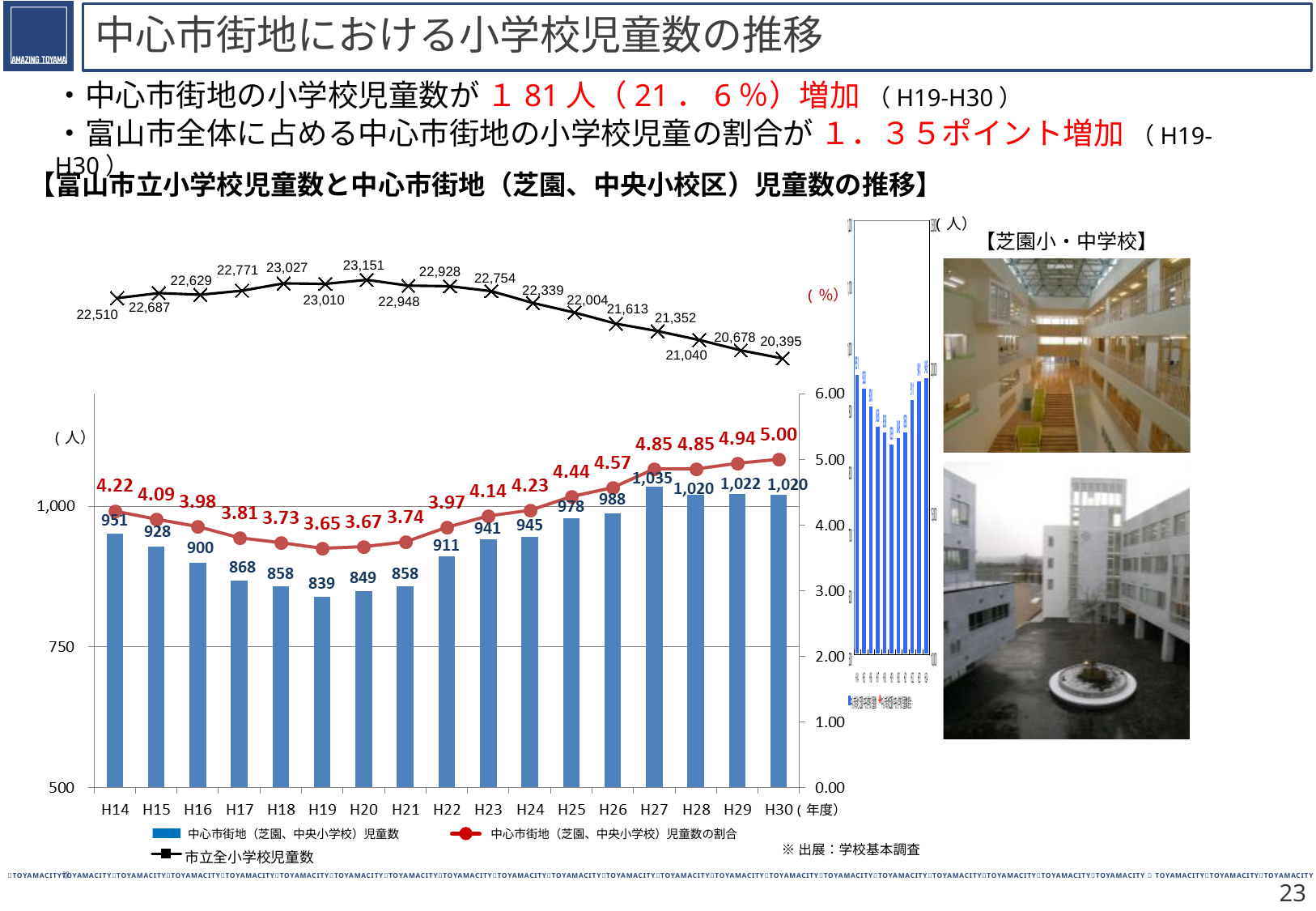
In the main chart, what is the total number of municipal elementary school children (市立全小学校児童数) for H20? 23,151 In the main chart, what is the share (%) of central city area children for H30? 5.00 How many series does the legend of the main chart list? 3 In the main chart, which is larger: the central city area children count in H14 or in H30? H30 In the main chart, how many years (categories) are shown on the x axis? 17 In the main chart, which year has the highest number of central city area children (bars)? H27 In the main chart, which year has the lowest share (%) of central city area children? H19 In the main chart, what is the difference between the central city area children count in H30 and in H19? 181 What kind of chart is the main chart on the slide? Combined bar and line chart In the main chart, what is the number of elementary school children in the central city area (中心市街地) for H19? 839 In the main chart, does the total municipal elementary school children line (市立全小学校児童数) rise or fall from H20 to H30? Fall In the main chart, which year has the lowest number of central city area children (bars)? H19